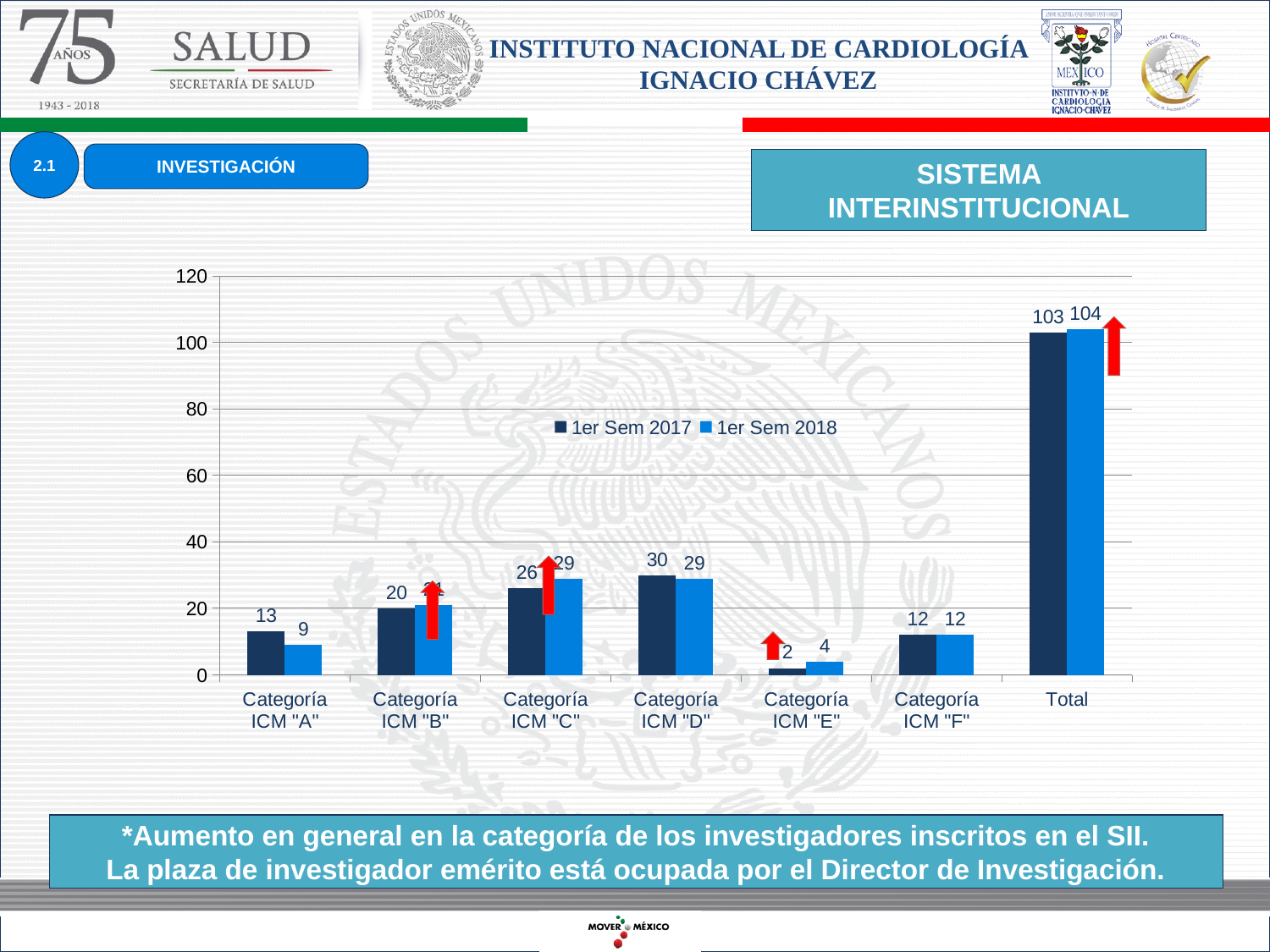
What is the value for Categoría ICM "C" in the 1er Sem 2018 series? 29 Excluding Total, which category has the highest value in the 1er Sem 2017 series? Categoría ICM "D" How many categories are shown along the x axis of the chart? 7 What kind of chart is shown on the slide? bar chart What is the value for Categoría ICM "A" in the 1er Sem 2017 series? 13 How many series does the chart legend list? 2 Which category has the lowest value in the 1er Sem 2017 series? Categoría ICM "E" Is the Total value for 1er Sem 2017 greater or less than 100? greater Which is larger for Categoría ICM "C": the 1er Sem 2017 value or the 1er Sem 2018 value? 1er Sem 2018 What is the difference between the 1er Sem 2017 and 1er Sem 2018 values for Categoría ICM "A"? 4 What is the Total value for 1er Sem 2018? 104 What is the value for Categoría ICM "A" in the 1er Sem 2018 series? 9